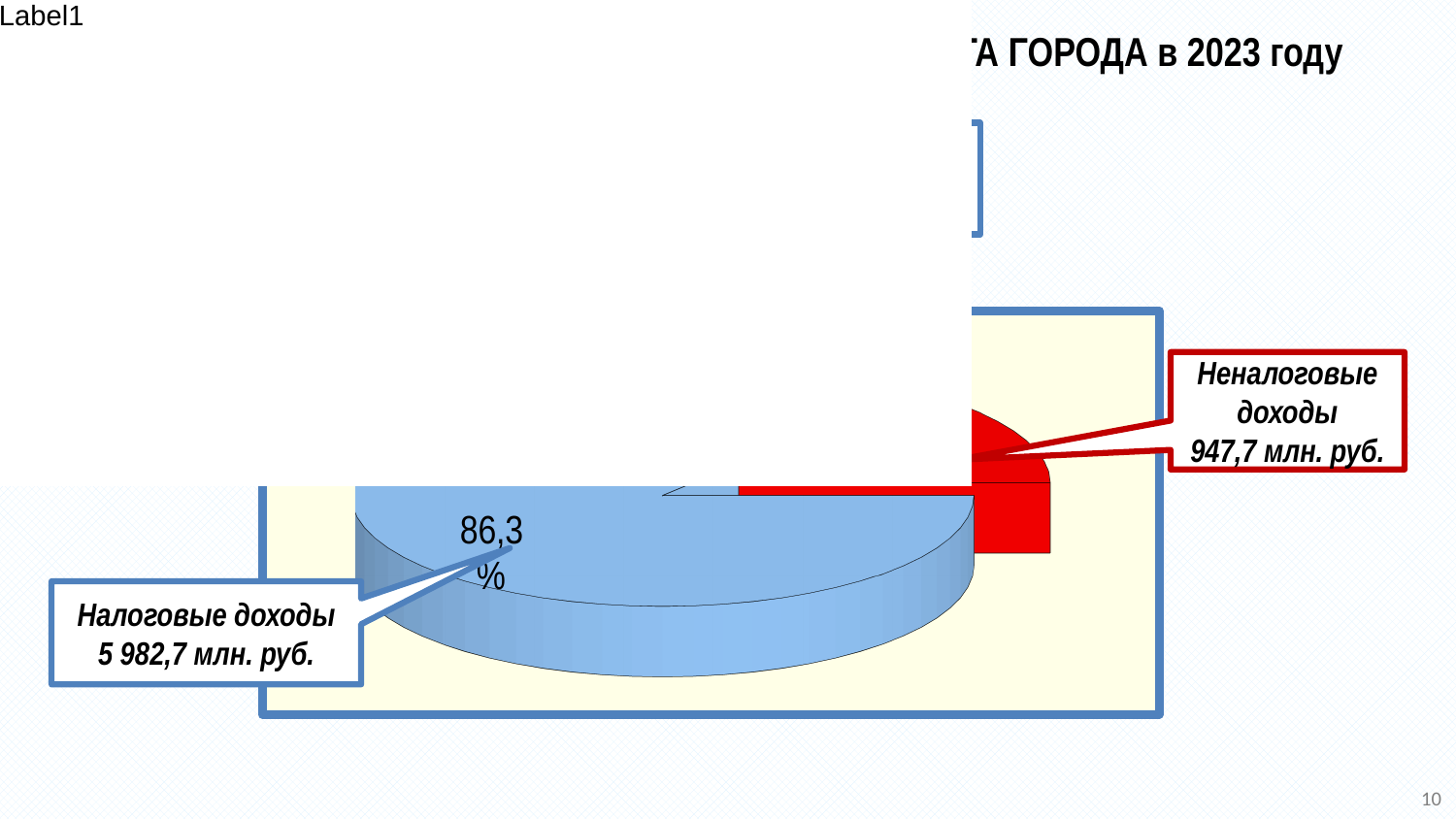
What share of the pie does the Налоговые доходы slice represent? 86,3 % What is the difference between Налоговые доходы and Неналоговые доходы in млн. руб.? 5 035,0 млн. руб. What is the value shown for Налоговые доходы? 5 982,7 млн. руб. What is the value shown for Неналоговые доходы? 947,7 млн. руб. Which category has the smallest slice of the pie? Неналоговые доходы What colour is the Налоговые доходы slice? blue Which is larger, Налоговые доходы or Неналоговые доходы? Налоговые доходы What colour is the Неналоговые доходы slice? red Which category has the largest slice of the pie? Налоговые доходы How many slices does the pie chart have? 2 What kind of chart is shown on the slide? pie chart